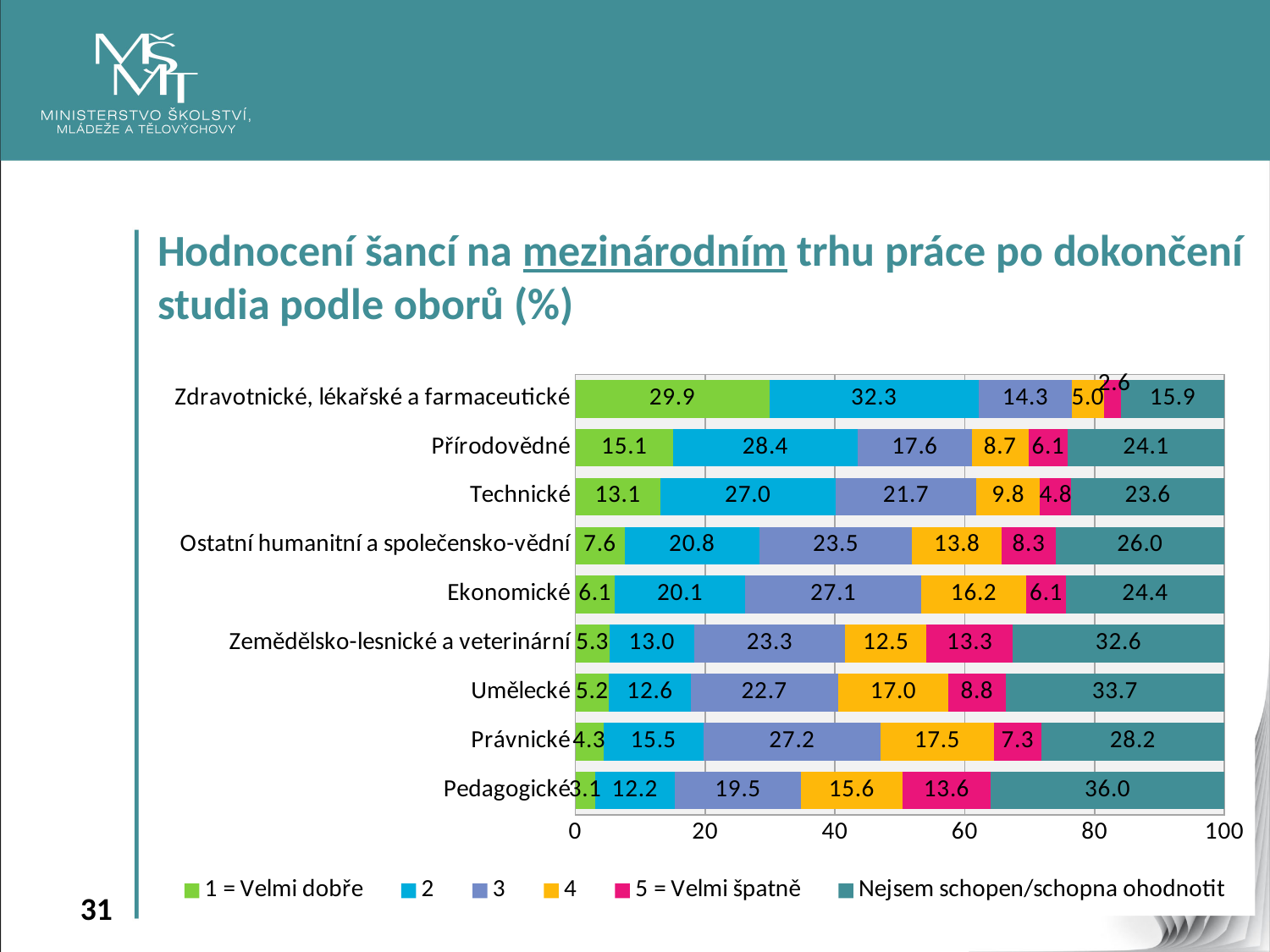
Which is larger: the '4' value for Právnické or the '4' value for Umělecké? Právnické How many fields of study (categories) are shown in the chart? 9 What is the value of 'Nejsem schopen/schopna ohodnotit' for Pedagogické? 36.0 Which field has the lowest value for '1 = Velmi dobře'? Pedagogické What type of chart is shown on the slide? Stacked bar chart How many series does the legend list? 6 What is the value of '1 = Velmi dobře' for Zdravotnické, lékařské a farmaceutické? 29.9 Which field has the highest value for '1 = Velmi dobře'? Zdravotnické, lékařské a farmaceutické What is the value of '5 = Velmi špatně' for Technické? 4.8 What is the value of series '3' for Ekonomické? 27.1 What is the difference between the '2' values for Zdravotnické, lékařské a farmaceutické (32.3) and Přírodovědné (28.4)? 3.9 What is the label of the last series in the legend? Nejsem schopen/schopna ohodnotit